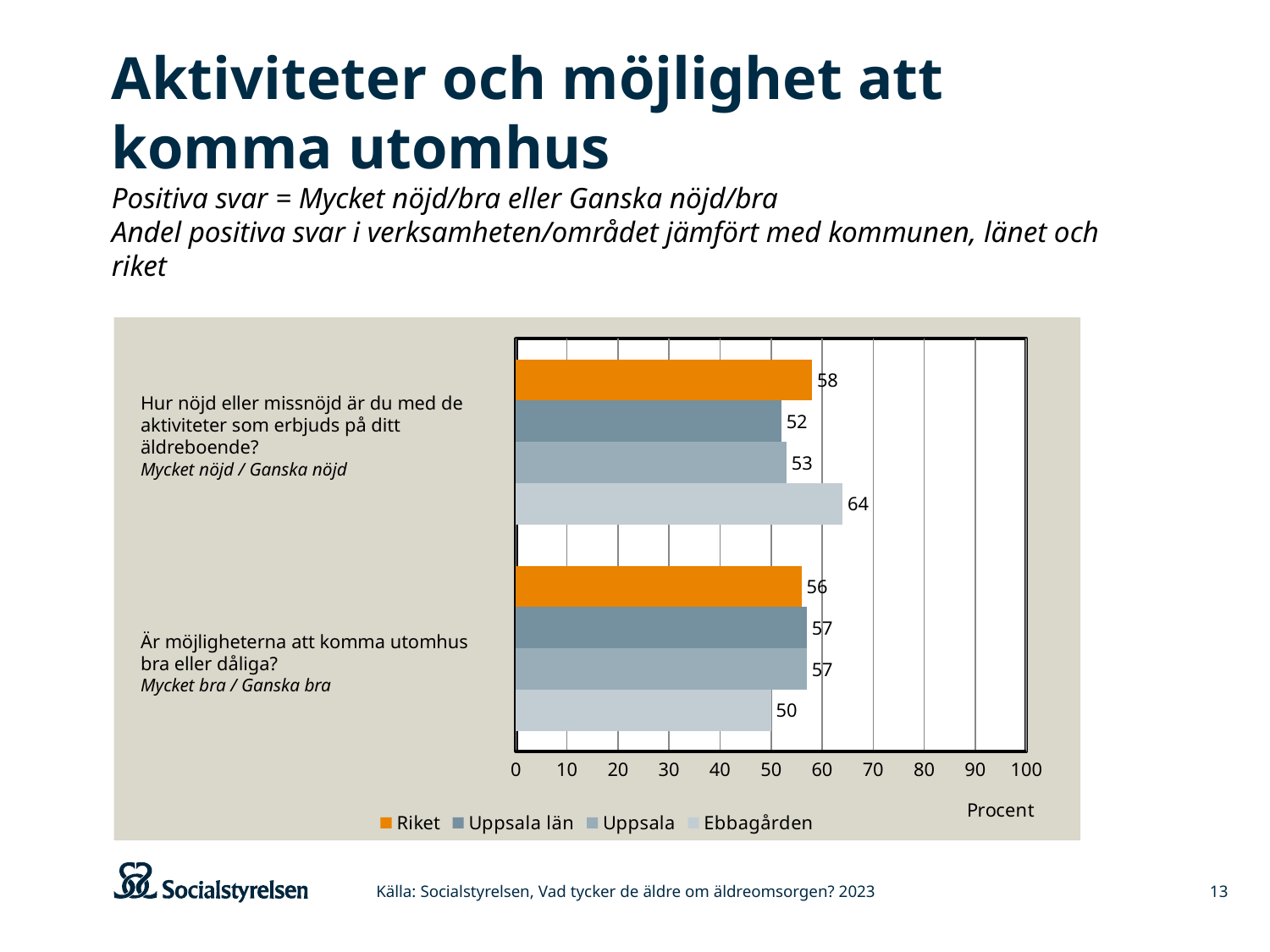
How many question categories are shown on the chart? 2 How many series does the legend list? 4 What kind of chart is shown on the slide? Bar chart What is the value for Ebbagården on the question about satisfaction with activities offered at the care home ("Hur nöjd eller missnöjd är du med de aktiviteter som erbjuds på ditt äldreboende?")? 64 Which series has the lowest value on the question about opportunities to get outdoors? Ebbagården What is the value for Ebbagården on the question about opportunities to get outdoors? 50 What is the difference between Ebbagården and Riket on the question about satisfaction with activities offered at the care home? 6 Which series has the highest value on the question about satisfaction with activities offered at the care home? Ebbagården On the question about opportunities to get outdoors, which is larger: the value for Uppsala län or the value for Ebbagården? Uppsala län What is the value for Riket on the question about opportunities to get outdoors ("Är möjligheterna att komma utomhus bra eller dåliga?")? 56 What is the value for Uppsala län on the question about satisfaction with activities offered at the care home? 52 What unit label is shown below the x axis of the chart? Procent